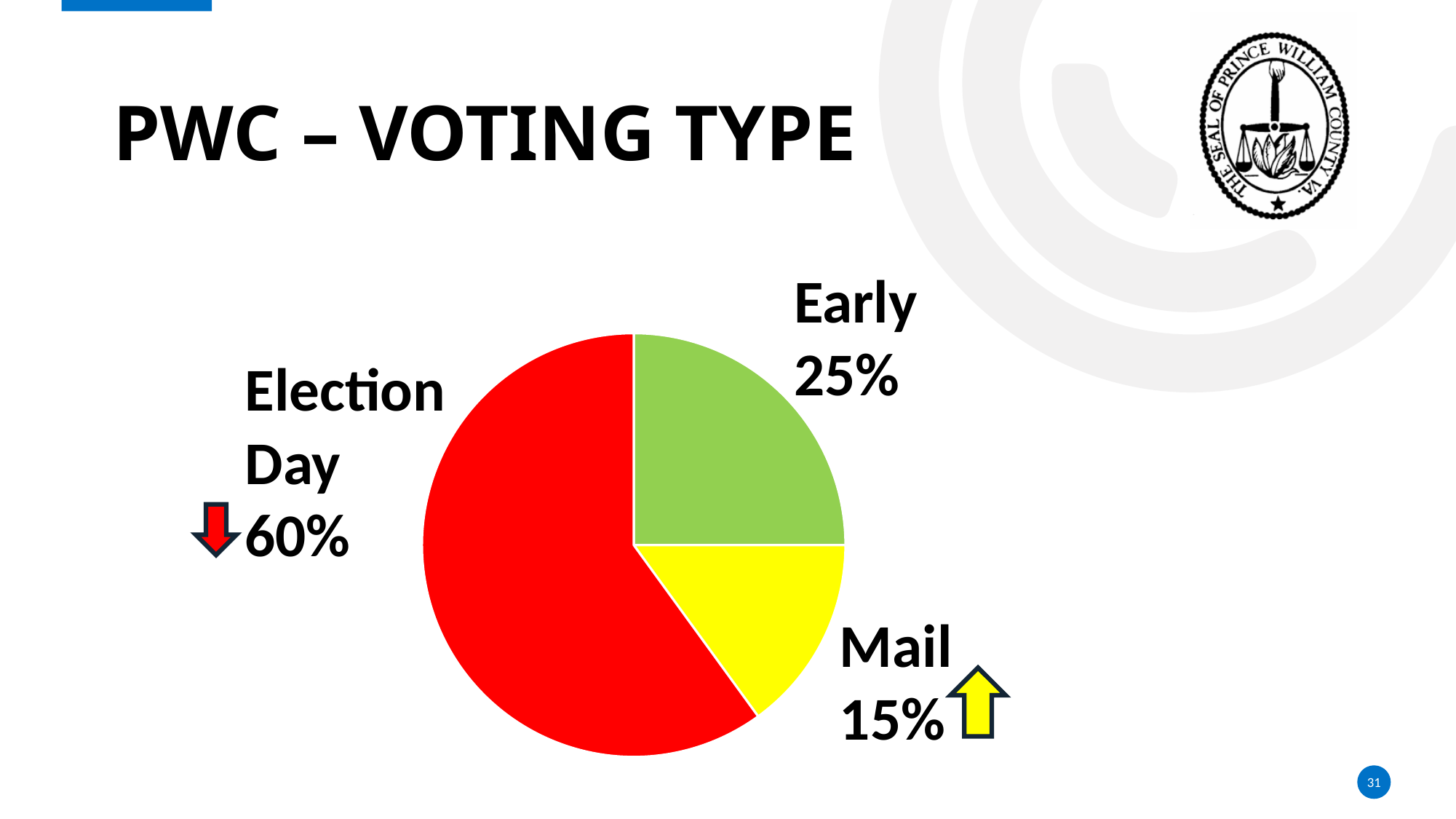
What share of the pie is Election Day? 60% Which voting type has the smallest share of the pie? Mail What is the difference in percentage points between Election Day and Early voting? 35 What is the title of the slide containing the pie chart? PWC – VOTING TYPE What colour is the Election Day slice of the pie? red What kind of chart is shown on the slide? pie chart What share of the pie is Mail voting? 15% Which voting type has the largest share of the pie? Election Day What is the difference in percentage points between Early and Mail voting? 10 Which is larger, the Early share or the Mail share? Early What share of the pie is Early voting? 25% How many slices does the pie chart have? 3